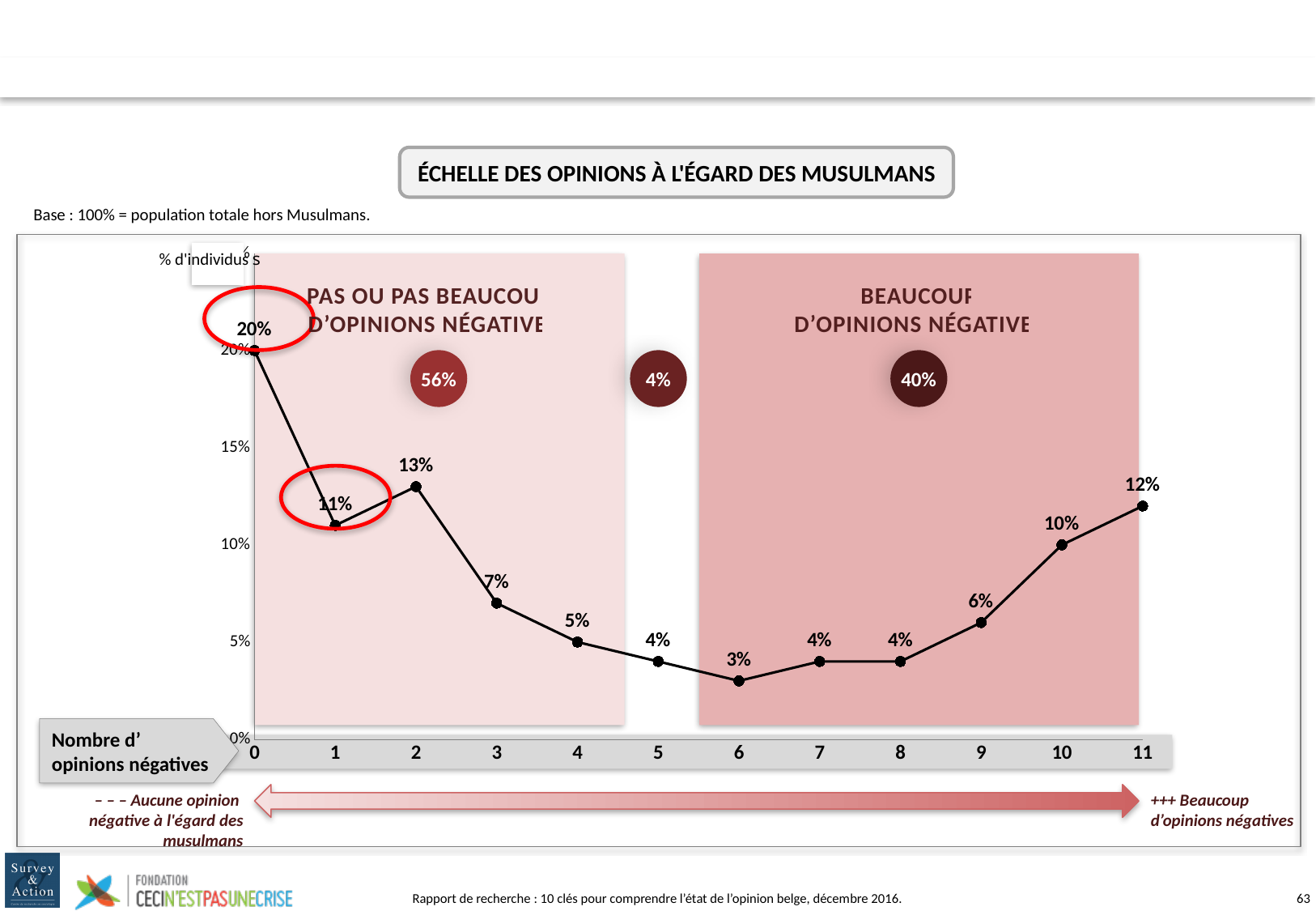
What percentage of individuals have 11 negative opinions? 12% Which number of negative opinions has the highest percentage of individuals? 0 Which number of negative opinions has the lowest percentage of individuals? 6 What is the title of the chart? ÉCHELLE DES OPINIONS À L'ÉGARD DES MUSULMANS How many points are plotted on the line? 12 What kind of chart is shown on the slide? Line chart What is the value for 6 negative opinions? 3% What is the value plotted for 2 negative opinions? 13% Do the values rise or fall from 6 to 11 negative opinions? Rise What is the difference between the value for 0 negative opinions and the value for 1 negative opinion? 9% Which is larger: the value for 2 negative opinions or the value for 10 negative opinions? 2 negative opinions What percentage of individuals have 0 negative opinions? 20%